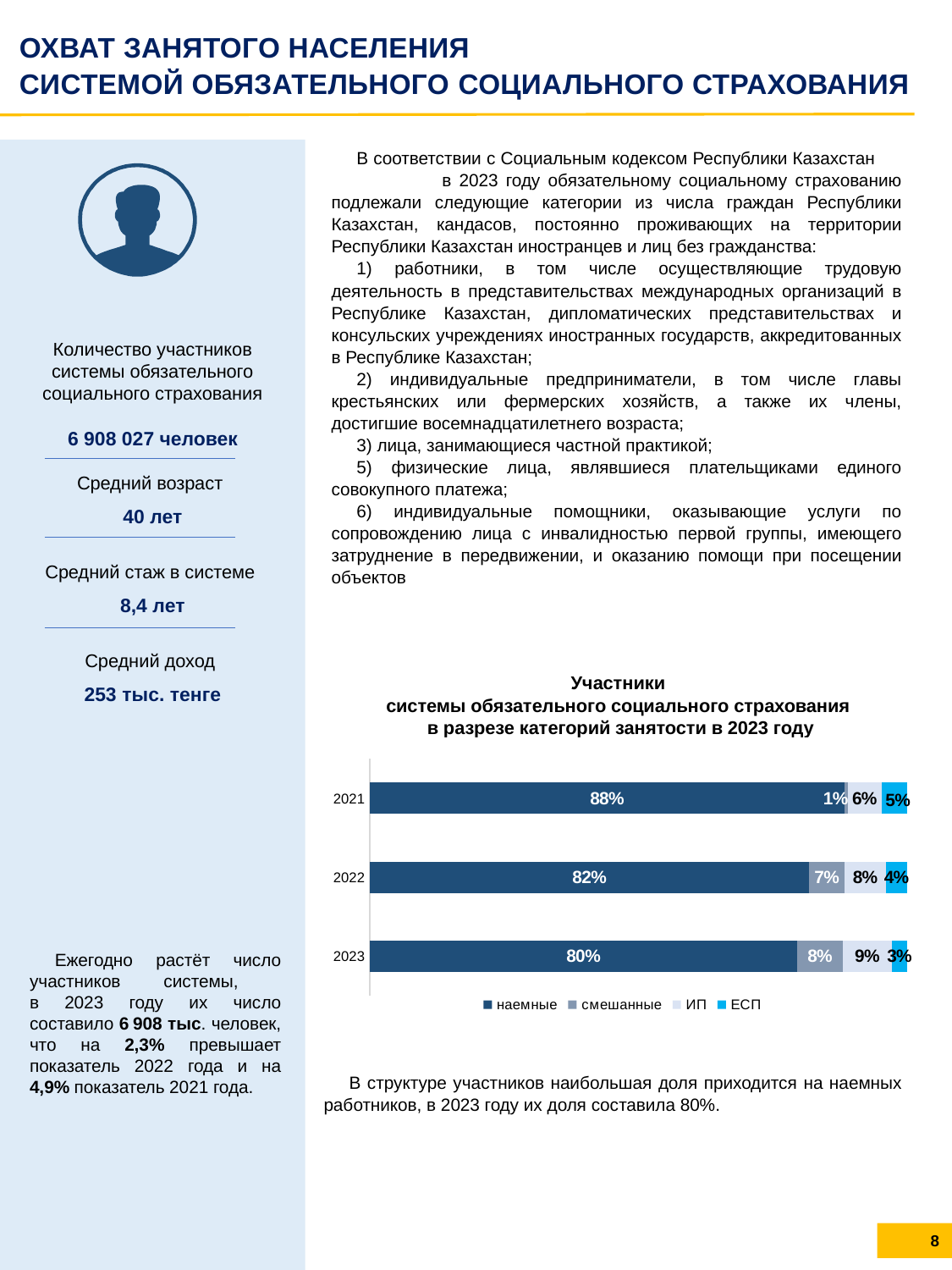
By how many percentage points did the share of наемные fall from 2021 to 2023? 8 percentage points What share of participants were смешанные in 2021? 1% Does the share of смешанные rise or fall from 2021 to 2023? Rise What share of participants were ИП in 2022? 8% What share of participants were ЕСП in 2023? 3% What share of participants were наемные (hired workers) in 2023? 80% In which year was the share of наемные the highest? 2021 How many series does the legend list? 4 In which year was the share of ЕСП the lowest? 2023 Which was larger in 2022: the share of смешанные or the share of ИП? ИП How many years are shown on the chart? 3 What kind of chart is shown on the slide? Stacked bar chart